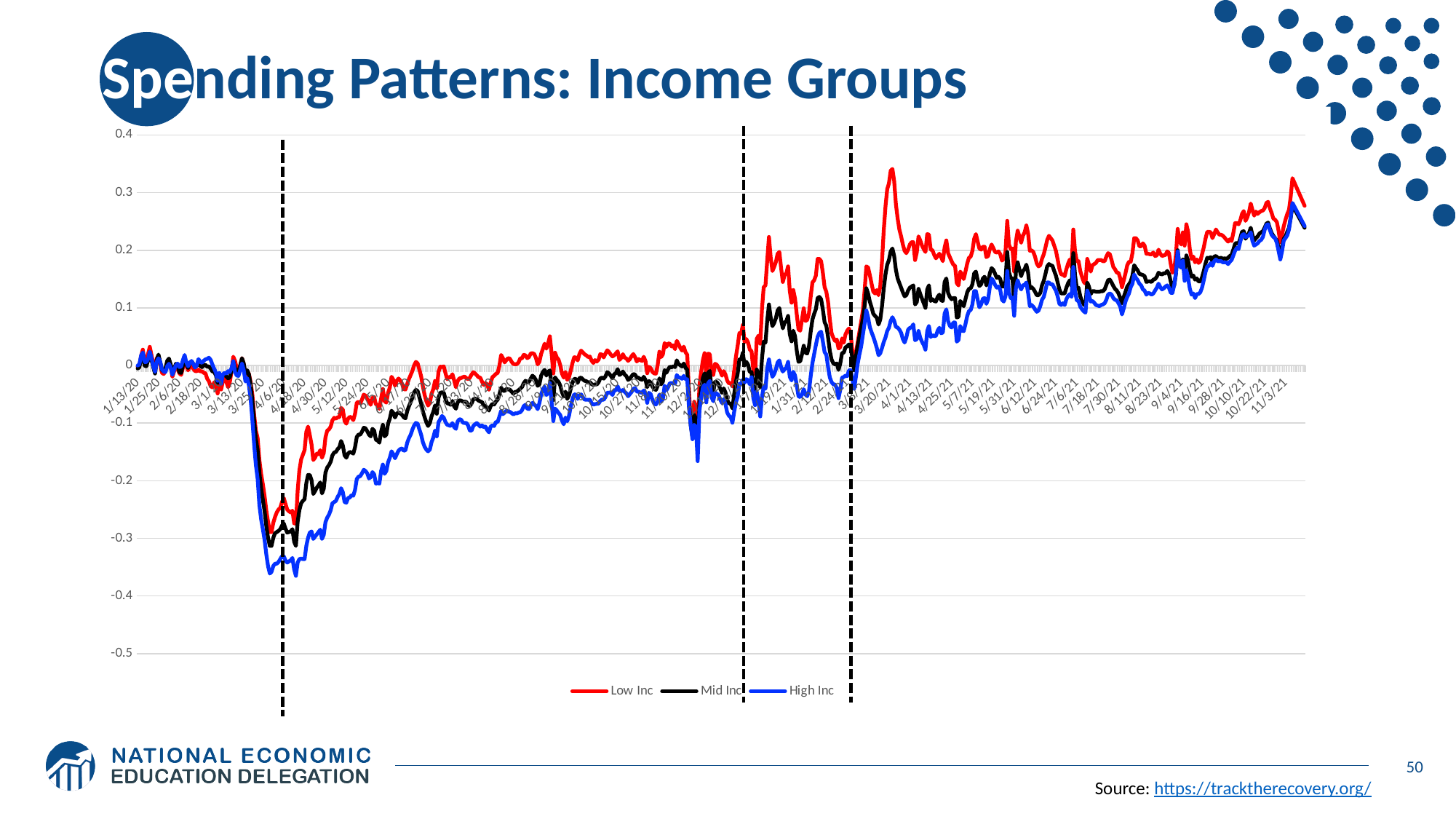
Is the lowest value of the Low Inc series in spring 2020 greater or less than -0.2? less Which series is drawn in blue? High Inc Is the peak of the Low Inc series around 4/1/21 greater or less than 0.3? greater Which series has the highest peak around 4/1/21? Low Inc How many series does the legend list? 3 Which series reaches the lowest value during the spring 2020 drop? High Inc Around 4/1/21, which series is higher: Low Inc or High Inc? Low Inc What is the title of the slide's chart? Spending Patterns: Income Groups Do the series generally rise or fall from April 2020 to November 2021? rise Is the lowest value of the High Inc series in spring 2020 greater or less than -0.3? less What kind of chart is shown on the slide? line chart